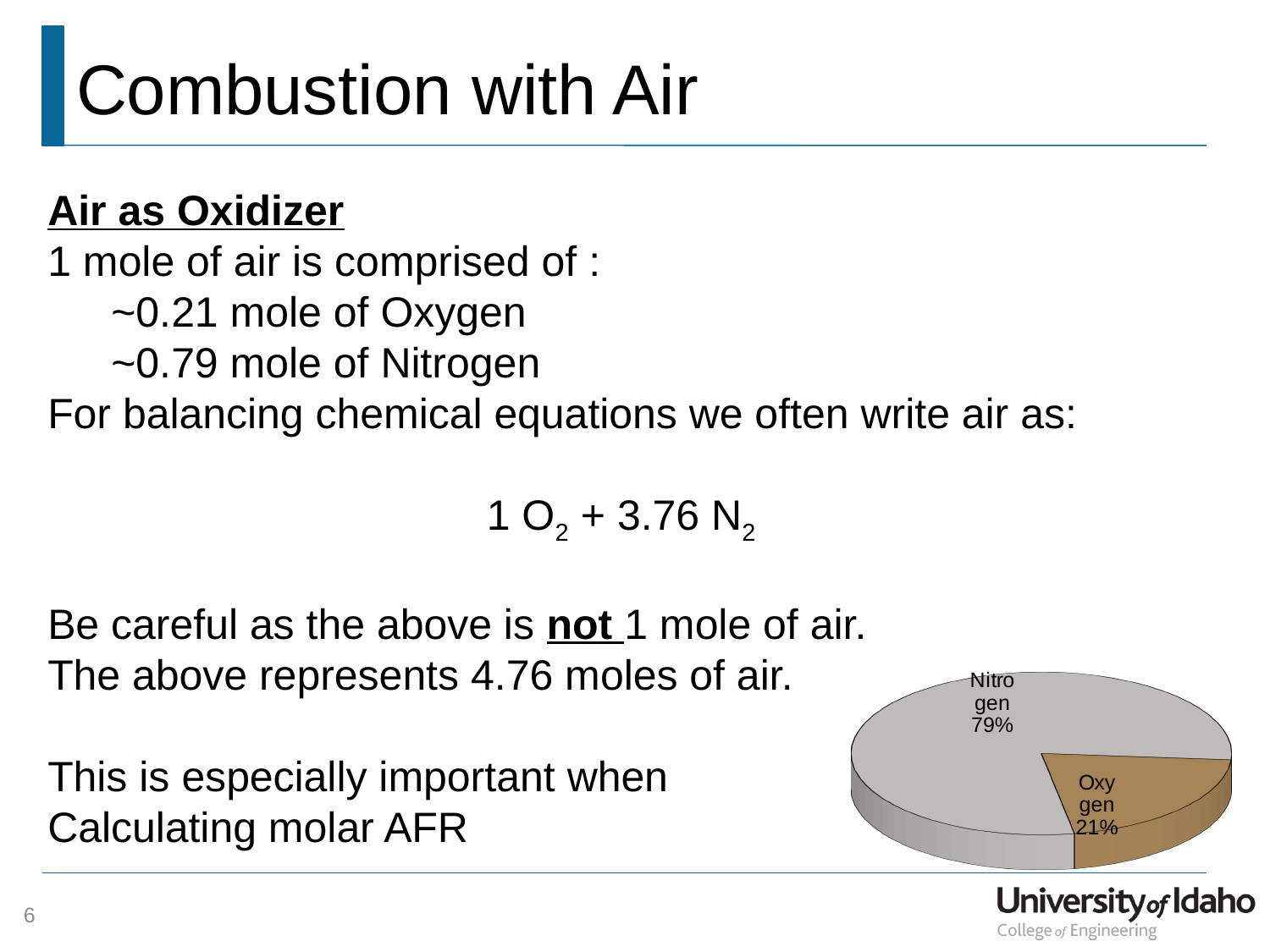
What colour is the Nitrogen slice in the pie chart? grey What is the difference in percentage points between the Nitrogen and Oxygen slices? 58 Which slice of the pie chart is the largest? Nitrogen What share of the pie does Nitrogen represent? 79% What share of the pie does Oxygen represent? 21% Which slice of the pie chart is the smallest? Oxygen What colour is the Oxygen slice in the pie chart? brown Which is larger in the pie chart, Nitrogen or Oxygen? Nitrogen How many slices does the pie chart have? 2 What kind of chart is shown on the slide? pie chart